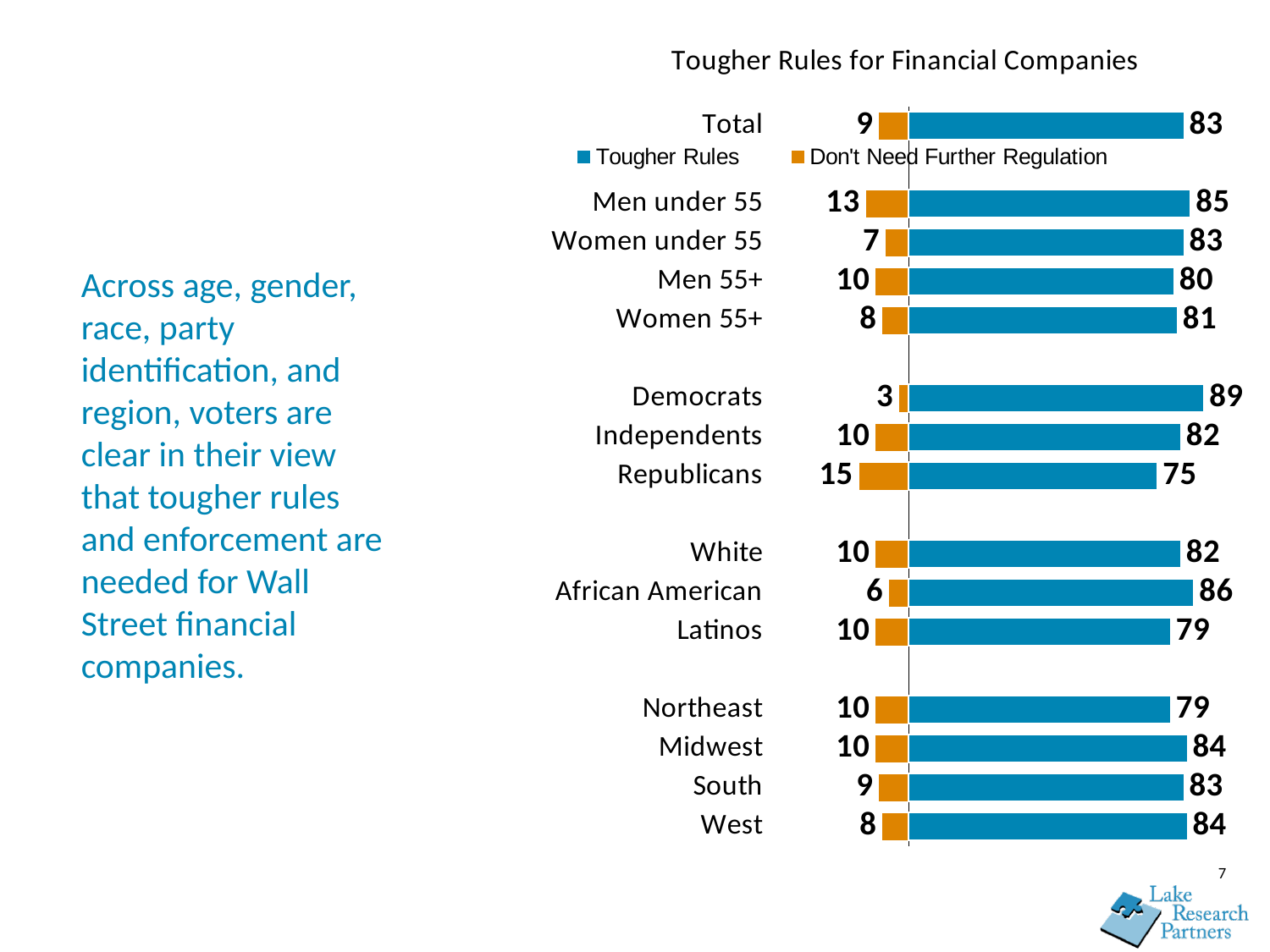
Which has a higher 'Tougher Rules' value, Men under 55 or Men 55+? Men under 55 What is the difference between the 'Tougher Rules' values for Democrats and Republicans? 14 What is the title of the chart? Tougher Rules for Financial Companies What is the 'Tougher Rules' value for Democrats? 89 What kind of chart is shown on the slide? Bar chart Which category has the lowest 'Tougher Rules' value? Republicans What is the 'Don't Need Further Regulation' value for Republicans? 15 What is the 'Don't Need Further Regulation' value for African American? 6 Which category has the highest 'Tougher Rules' value? Democrats Which category has the lowest 'Don't Need Further Regulation' value? Democrats How many series does the legend list? 2 What is the 'Tougher Rules' value for the Total category? 83